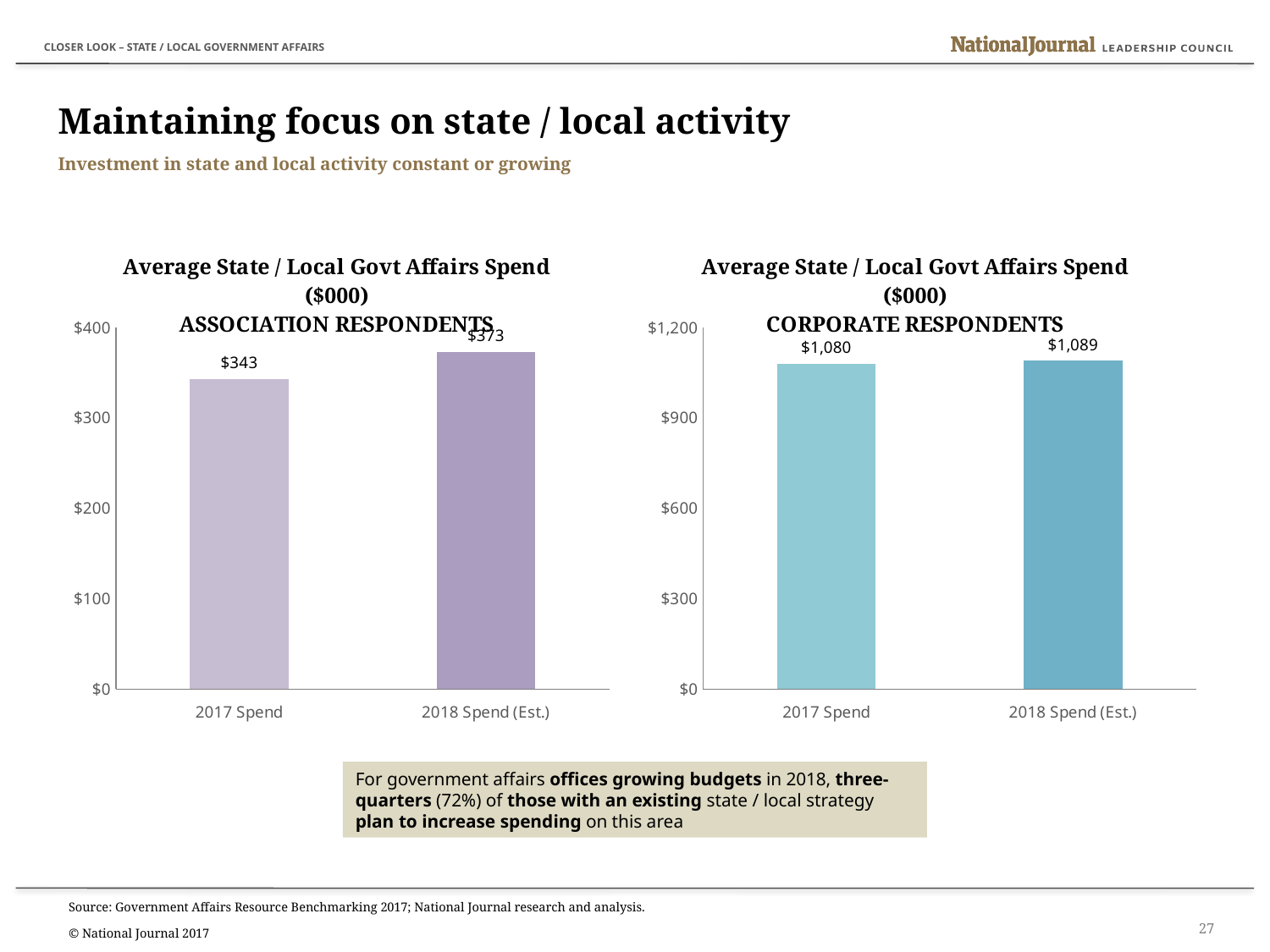
In the Corporate Respondents chart, what is the value for 2017 Spend? $1,080 In the Association Respondents chart, do the values rise or fall from 2017 Spend to 2018 Spend (Est.)? Rise In the Corporate Respondents chart, is the value for 2018 Spend (Est.) greater or less than $1,200? less In the Association Respondents chart, what is the value for 2018 Spend (Est.)? $373 In the Association Respondents chart, what is the value for 2017 Spend? $343 How many categories are shown in the Corporate Respondents chart? 2 In the Corporate Respondents chart, what is the difference between 2018 Spend (Est.) and 2017 Spend? $9 In the Association Respondents chart, which category has the higher value? 2018 Spend (Est.) In the Association Respondents chart, what is the difference between 2018 Spend (Est.) and 2017 Spend? $30 What kind of chart is the Association Respondents chart? Bar chart In the Corporate Respondents chart, what is the value for 2018 Spend (Est.)? $1,089 In the Association Respondents chart, is the value for 2017 Spend greater or less than $300? greater